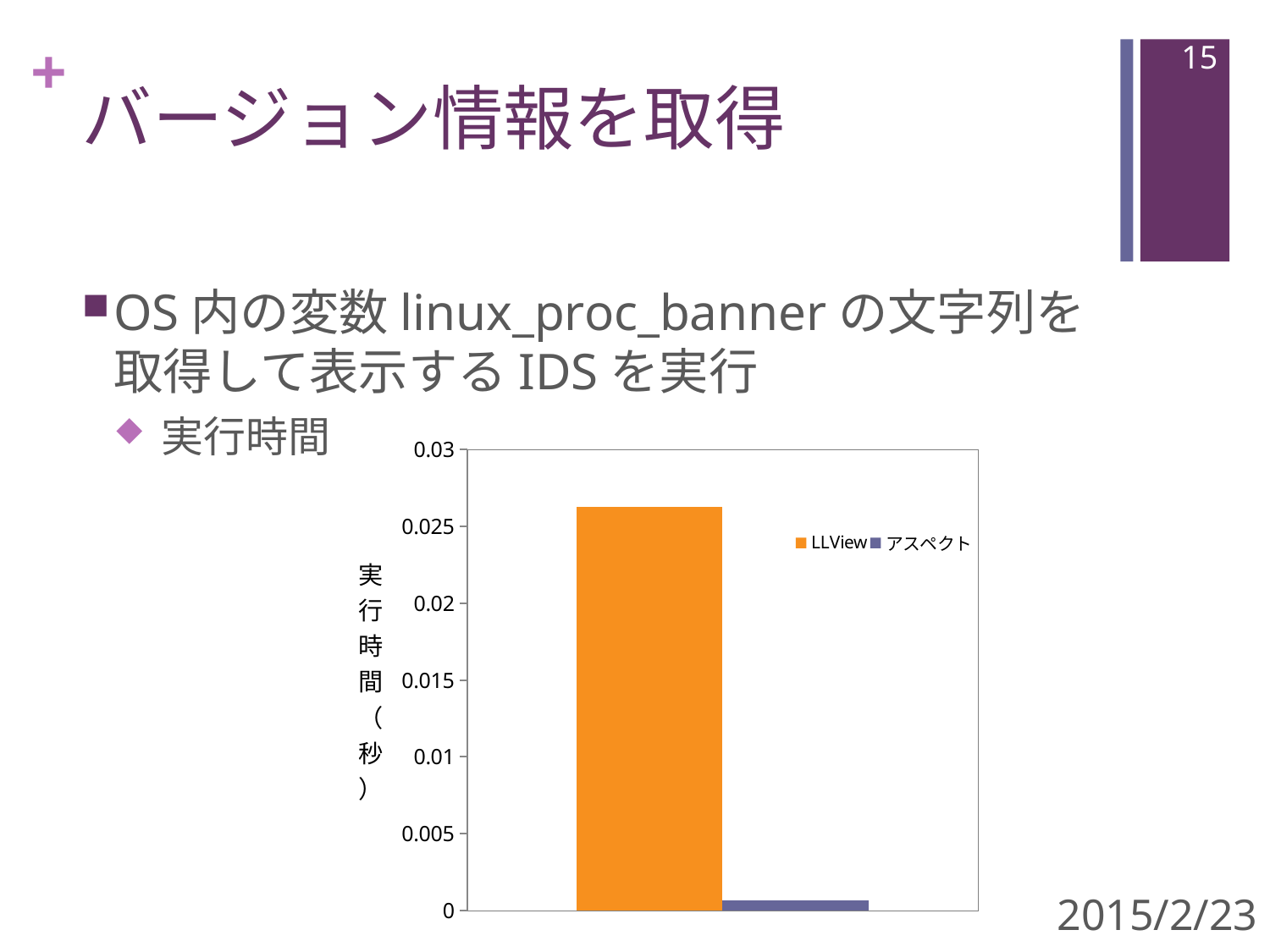
Is the execution time for LLView greater or less than 0.02? greater Which series has the higher execution time, LLView or アスペクト? LLView What is the label of the vertical axis of the chart? 実行時間(秒) Is the execution time for アスペクト greater or less than 0.005? less Which series has the lowest execution time in the chart? アスペクト Which series has the highest execution time in the chart? LLView Is the execution time for LLView greater or less than 0.03? less How many series does the chart legend list? 2 What colour is the bar for LLView in the chart? orange What is the maximum value shown on the vertical axis of the chart? 0.03 What kind of chart is shown on the slide? bar chart